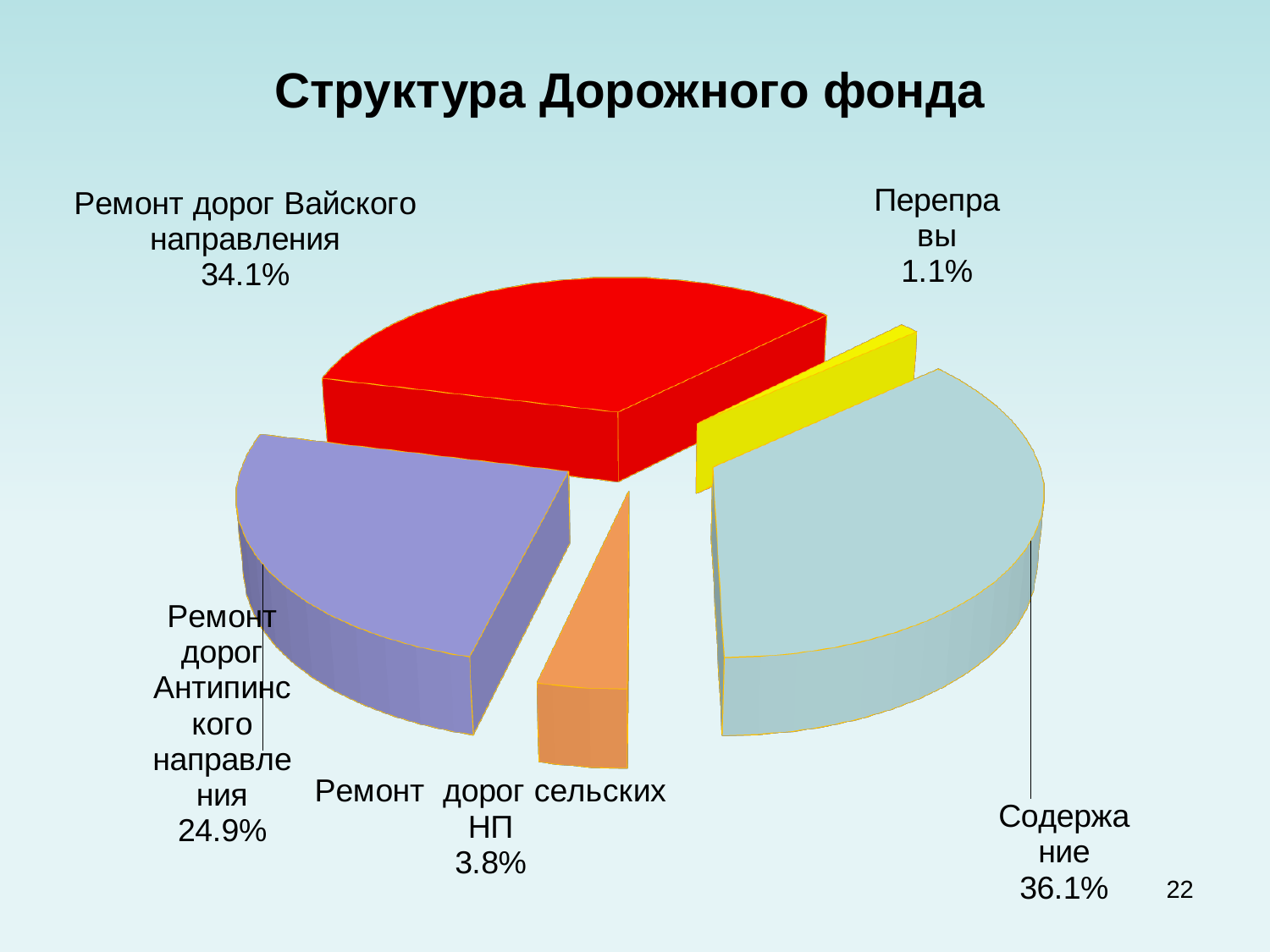
What share of the pie is Содержание? 36.1% What share of the pie is Ремонт дорог Вайского направления? 34.1% Which category has the smallest share of the pie? Переправы What share of the pie is Ремонт дорог сельских НП? 3.8% What kind of chart is shown on the slide? Pie chart What is the title of the chart? Структура Дорожного фонда Which category has the largest share of the pie? Содержание Which is larger: the share for Ремонт дорог сельских НП or the share for Переправы? Ремонт дорог сельских НП What is the difference in percentage points between Содержание and Ремонт дорог Антипинского направления? 11.2 How many slices does the pie chart have? 5